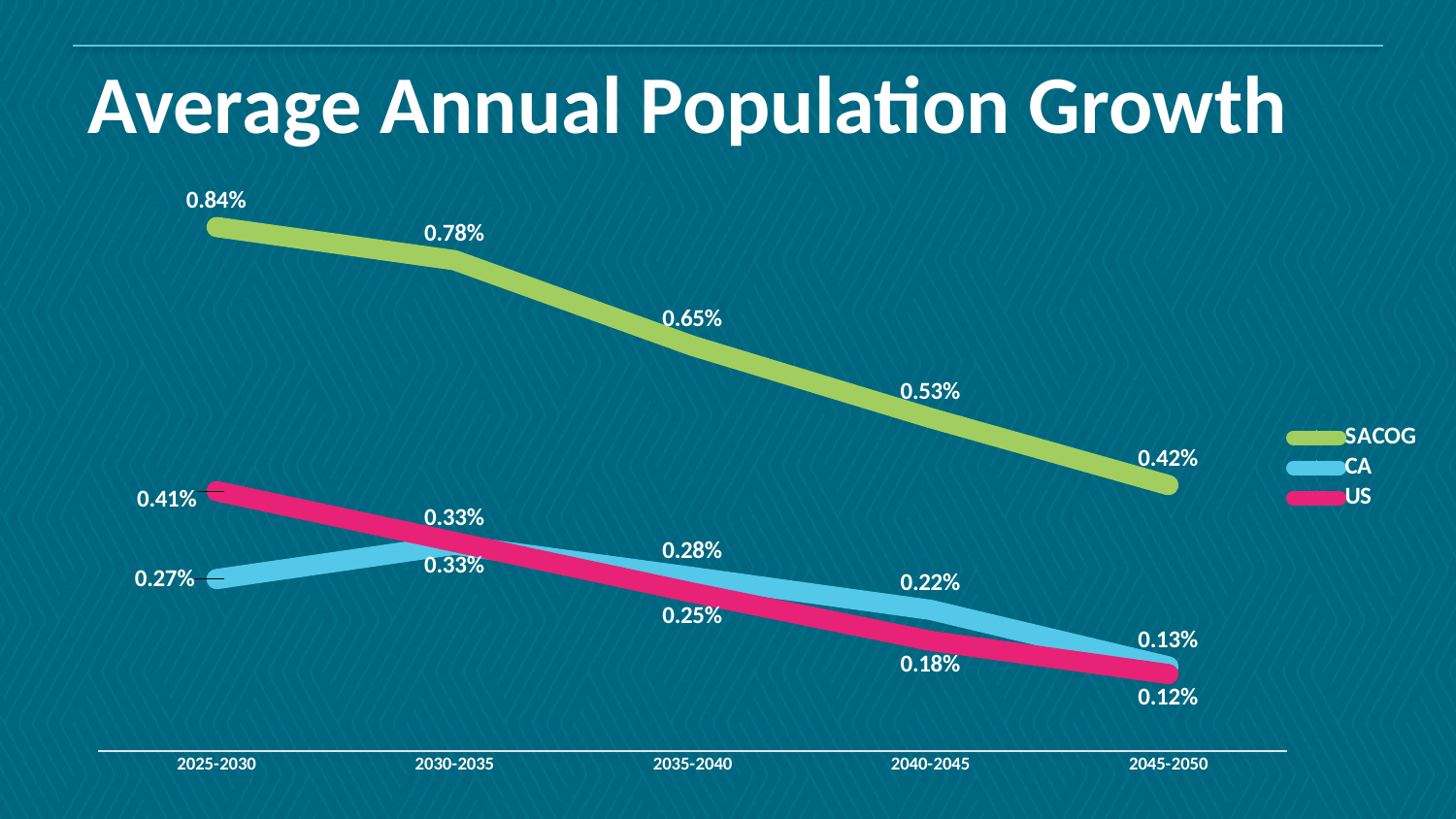
What is the SACOG value for 2025-2030? 0.84% What kind of chart is shown on the slide? Line chart How many series does the legend list? 3 Which is larger for 2040-2045, the CA value or the US value? CA What is the difference between the SACOG and US values for 2025-2030? 0.43% What colour is the line for the US series? Pink What is the US value for 2035-2040? 0.25% What is the CA value for 2045-2050? 0.13% How many periods are shown on the x axis? 5 Does the SACOG series rise or fall from 2025-2030 to 2045-2050? Fall In which period is the SACOG value lowest? 2045-2050 In which period is the CA value highest? 2030-2035